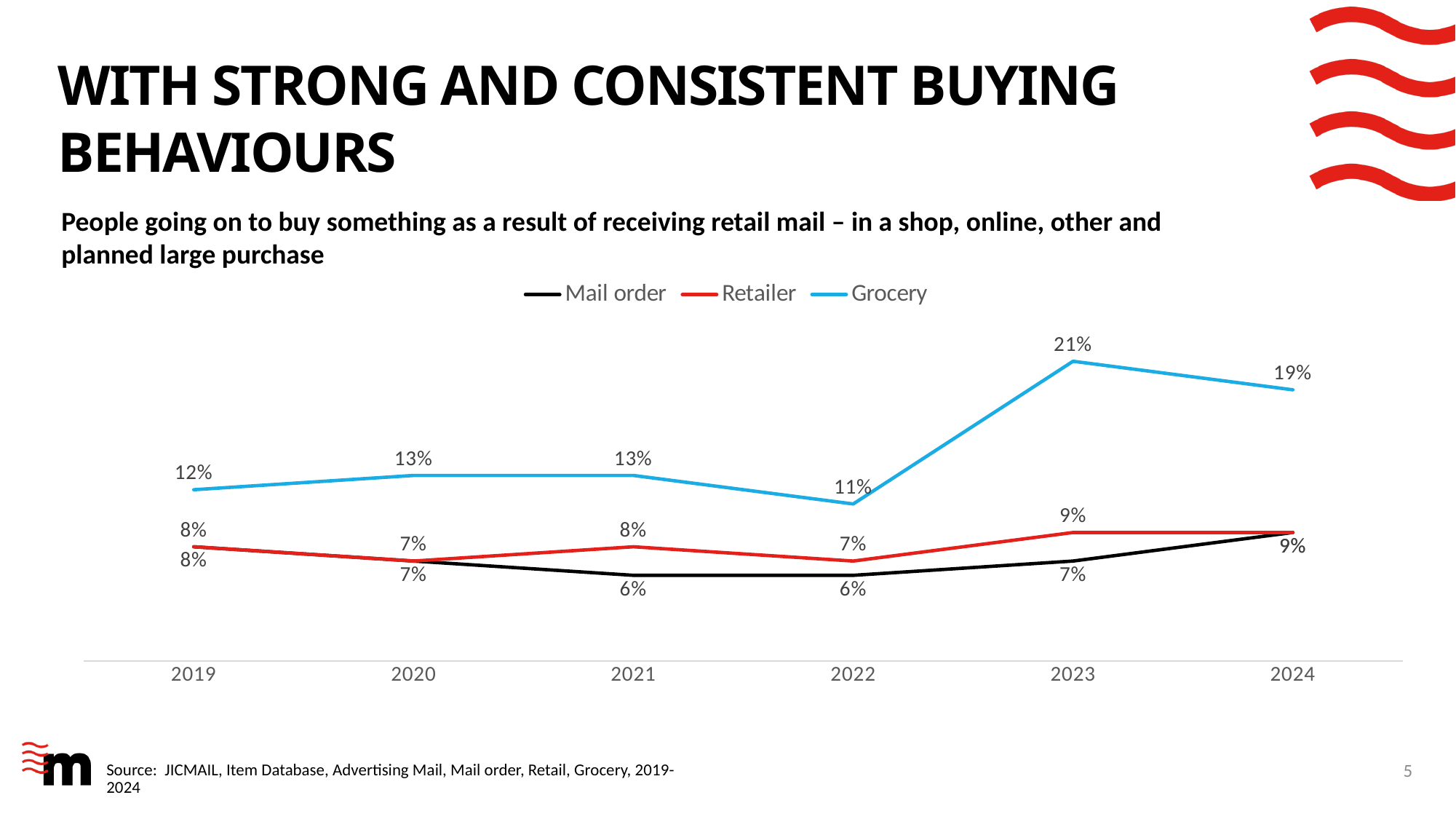
What is the difference between the Grocery value in 2023 and in 2022? 10% Does the Grocery line rise or fall from 2023 to 2024? fall How many series does the legend list? 3 What type of chart is shown on the slide? line chart What is the Grocery value for 2023? 21% In which year is the Grocery value lowest? 2022 Which is larger in 2023, the Retailer value or the Mail order value? Retailer Which colour is used for the Grocery line? blue What is the Mail order value for 2021? 6% How many years are shown on the x axis? 6 What is the Retailer value for 2022? 7% In which year is the Grocery value highest? 2023